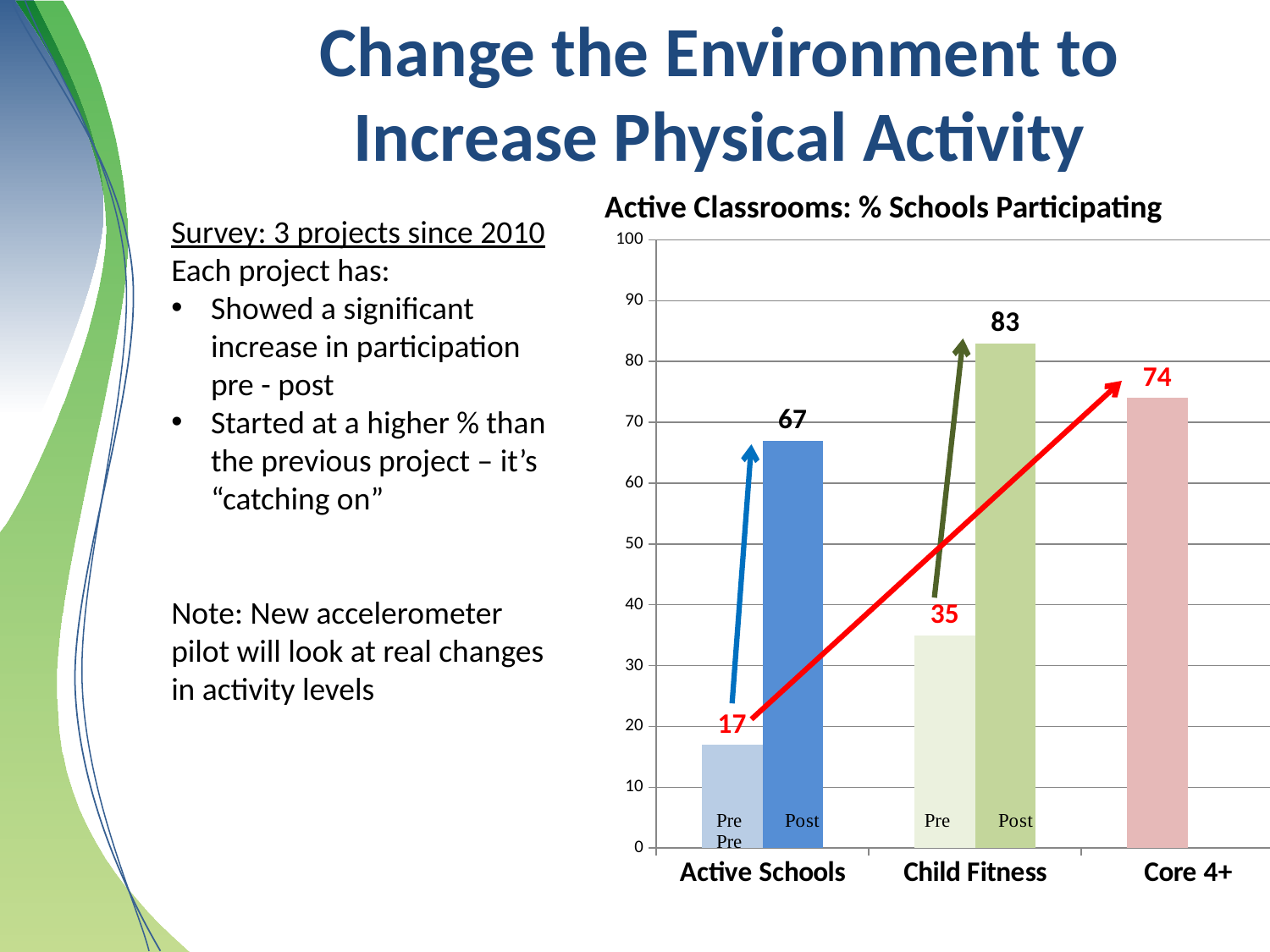
What is the Pre value for Child Fitness? 35 What is the title of the chart? Active Classrooms: % Schools Participating What is the Post value for Child Fitness? 83 What is the Post value for Active Schools? 67 What is the difference between the Post and Pre values for Child Fitness? 48 What is the value shown for Core 4+? 74 What is the difference between the Post and Pre values for Active Schools? 50 Which bar has the lowest value in the chart? Active Schools Pre What is the Pre value for Active Schools? 17 Which is larger, the Core 4+ value or the Active Schools Post value? Core 4+ What type of chart is shown on the slide? bar chart Which bar has the highest value in the chart? Child Fitness Post